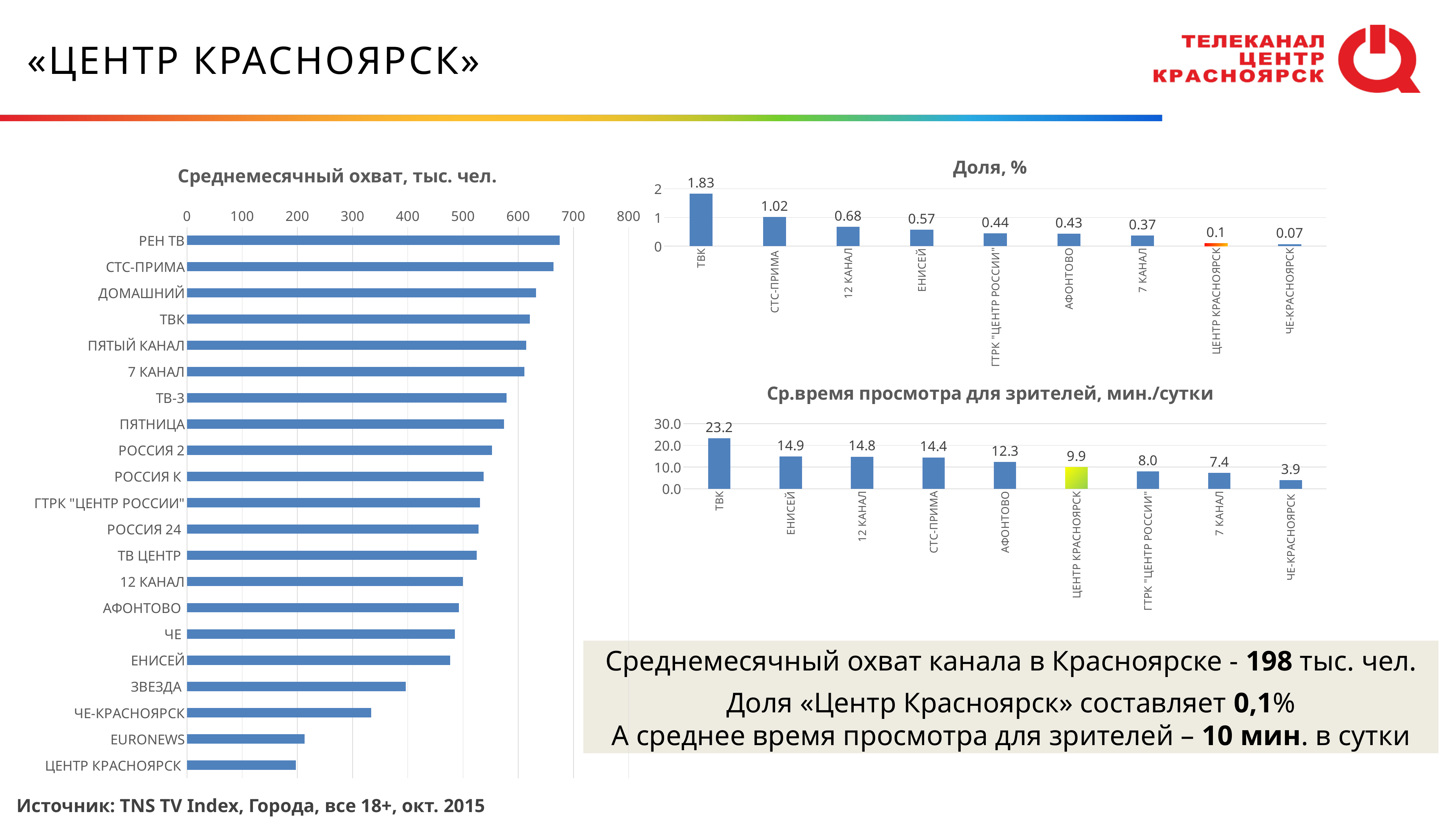
In the chart titled "Ср.время просмотра для зрителей, мин./сутки", how many channels are shown? 9 In the chart titled "Среднемесячный охват, тыс. чел.", is the value for РЕН ТВ greater or less than 600? greater In the chart titled "Ср.время просмотра для зрителей, мин./сутки", which channel has the highest value? ТВК In the chart titled "Доля, %", what is the difference between the values for СТС-ПРИМА and 12 КАНАЛ? 0.34 In the chart titled "Доля, %", which is larger, the value for АФОНТОВО or for 7 КАНАЛ? АФОНТОВО In the chart titled "Ср.время просмотра для зрителей, мин./сутки", what is the difference between the values for ТВК and ЕНИСЕЙ? 8.3 What kind of chart is the one titled "Среднемесячный охват, тыс. чел."? bar chart In the chart titled "Доля, %", which channel has the lowest share? ЧЕ-КРАСНОЯРСК In the chart titled "Доля, %", what is the value for ТВК? 1.83 In the chart titled "Ср.время просмотра для зрителей, мин./сутки", what is the value for ЦЕНТР КРАСНОЯРСК? 9.9 In the chart titled "Доля, %", which channel has the highest share? ТВК In the chart titled "Среднемесячный охват, тыс. чел.", is the value for EURONEWS greater or less than 300? less